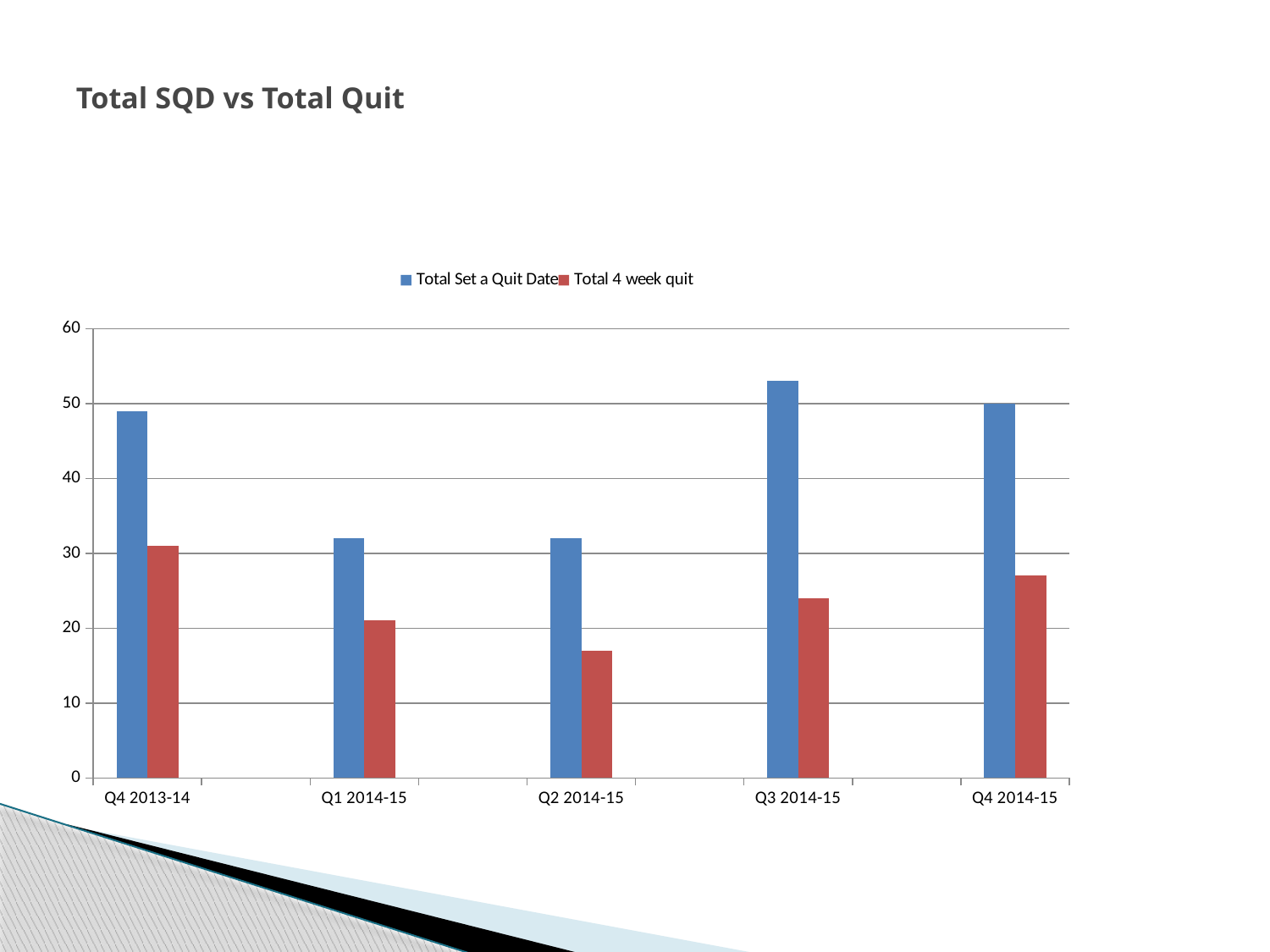
Is the Total Set a Quit Date value for Q3 2014-15 greater or less than 50? greater In which quarter is the Total 4 week quit value lowest? Q2 2014-15 Which is larger: the Total Set a Quit Date value for Q4 2013-14 or for Q3 2014-15? Q3 2014-15 What kind of chart is shown on the slide? bar chart How many series does the chart's legend list? 2 In which quarter is the Total Set a Quit Date value highest? Q3 2014-15 Which series is shown in red in the chart? Total 4 week quit In which quarter is the Total 4 week quit value highest? Q4 2013-14 What is the title of the chart on the slide? Total SQD vs Total Quit How many quarters are shown on the x axis of the chart? 5 Is the Total 4 week quit value for Q2 2014-15 greater or less than 20? less